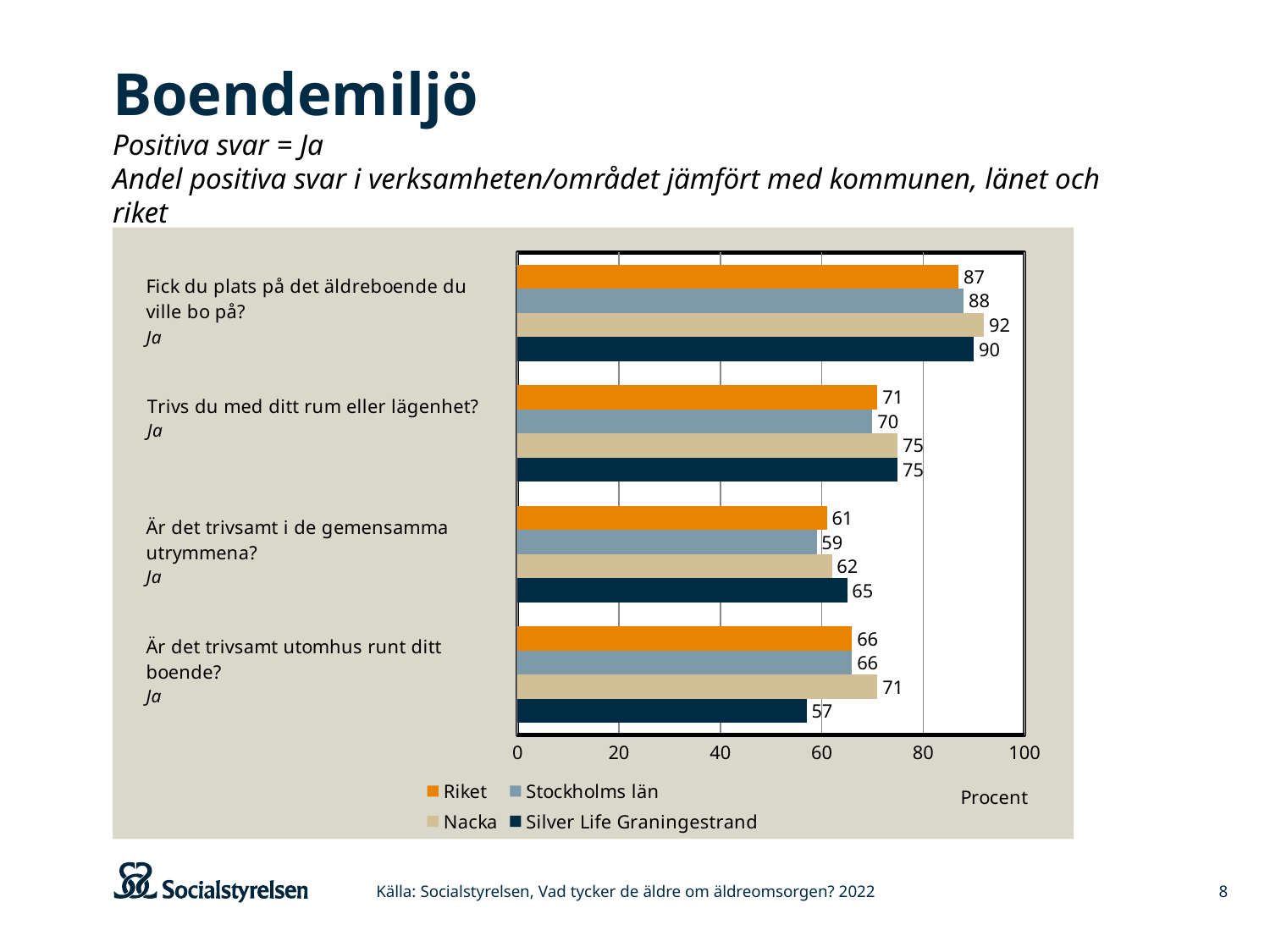
What kind of chart is shown on the slide? Bar chart What is the value for Silver Life Graningestrand on "Fick du plats på det äldreboende du ville bo på?"? 90 What unit is shown on the x axis of the chart? Procent Which is larger on "Är det trivsamt i de gemensamma utrymmena?": Silver Life Graningestrand or Riket? Silver Life Graningestrand How many series does the legend list? 4 Which series has the lowest value on "Är det trivsamt utomhus runt ditt boende?"? Silver Life Graningestrand What is the value for Nacka on "Trivs du med ditt rum eller lägenhet?"? 75 What is the value for Stockholms län on "Är det trivsamt i de gemensamma utrymmena?"? 59 What is the value for Riket on "Är det trivsamt utomhus runt ditt boende?"? 66 What is the difference between Nacka and Silver Life Graningestrand on "Är det trivsamt utomhus runt ditt boende?"? 14 How many survey questions (categories) are shown in the chart? 4 Which series has the highest value on "Fick du plats på det äldreboende du ville bo på?"? Nacka